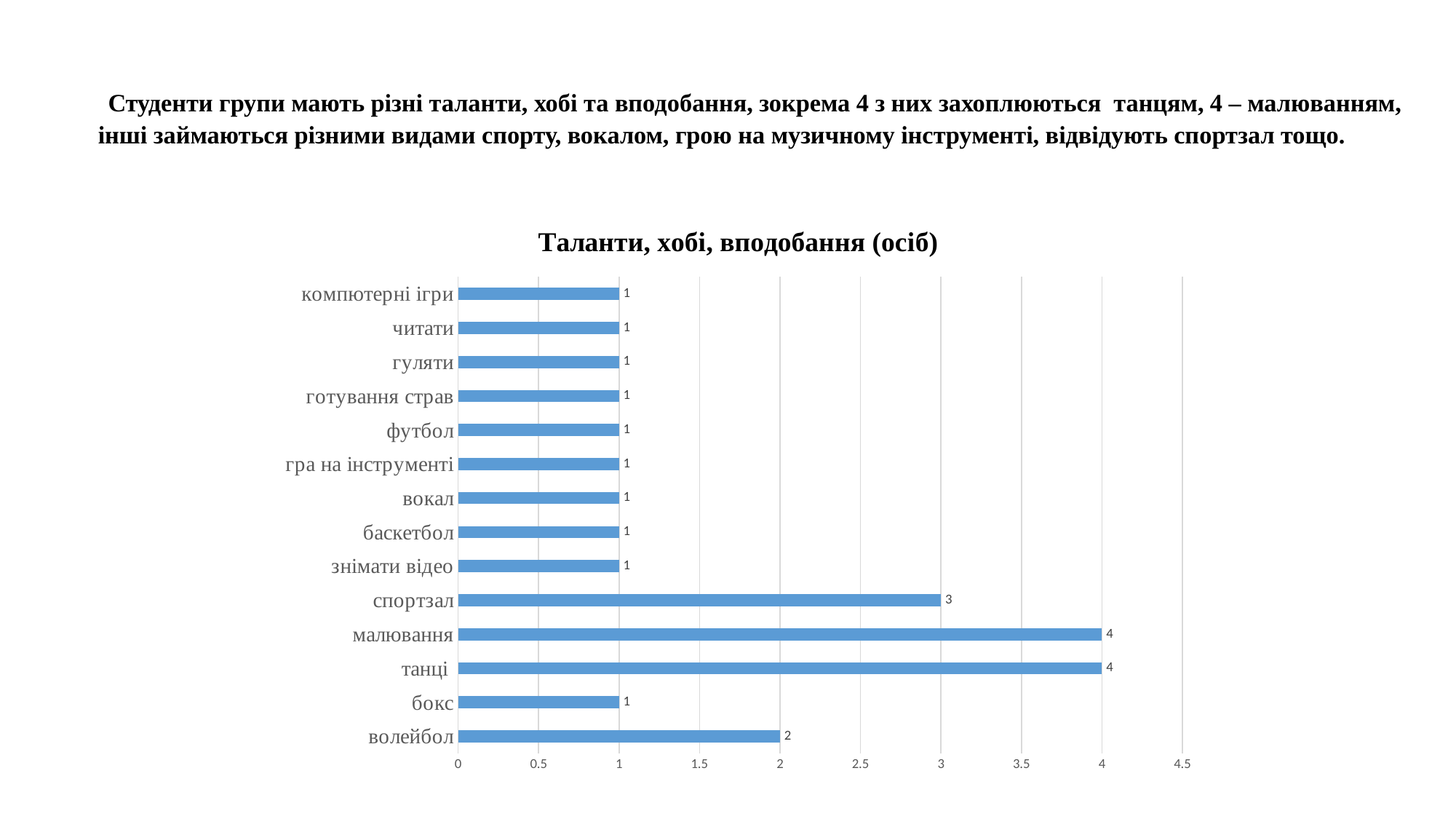
What is the value for танці? 4 What is the title of the chart? Таланти, хобі, вподобання (осіб) What is the difference between the values for спортзал and волейбол? 1 What is the value for малювання? 4 What kind of chart is shown on the slide? bar chart How many categories are shown in the chart? 14 What is the value for волейбол? 2 What is the difference between the values for танці and бокс? 3 Is the value for танці greater or less than 3.5? greater Which is larger, the value for спортзал or the value for волейбол? спортзал What is the value for бокс? 1 What is the value for спортзал? 3